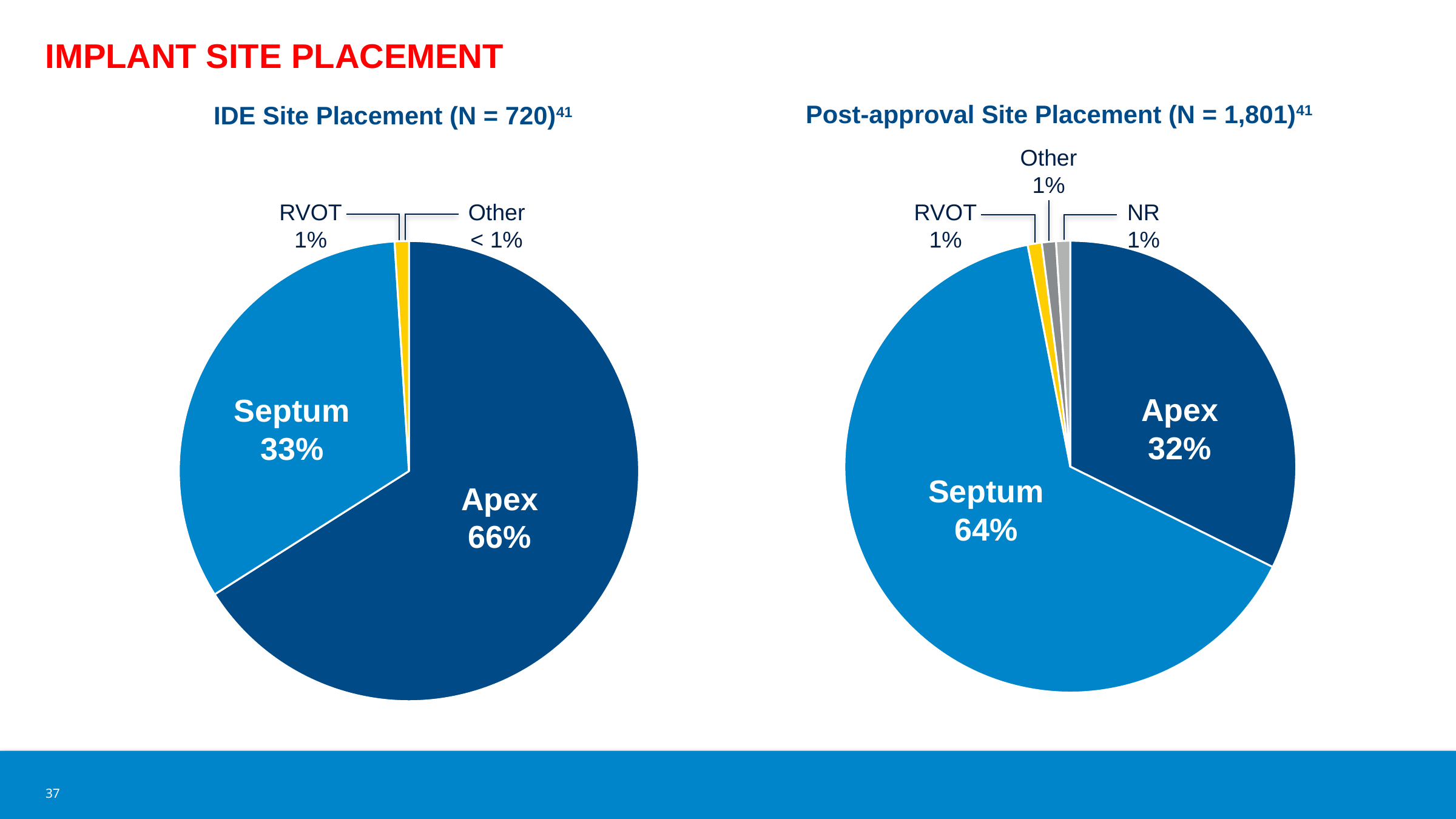
In the IDE Site Placement chart, what share of implants were placed at the Septum? 33% In the Post-approval Site Placement chart, what share of implants were placed at the Apex? 32% In the Post-approval Site Placement chart, what share is labelled NR? 1% In the Post-approval Site Placement chart, which is larger, the Septum share or the Apex share? Septum In the Post-approval Site Placement chart, what share of implants were placed at the Septum? 64% In the IDE Site Placement chart, what is the difference between the Apex and Septum shares? 33% What type of chart is used for IDE Site Placement? Pie chart In the Post-approval Site Placement chart, what is the difference between the Septum and Apex shares? 32% In the IDE Site Placement chart, what share of implants were placed at the Apex? 66% In the Post-approval Site Placement chart, which site has the largest share? Septum How many slices does the Post-approval Site Placement pie chart have? 5 In the IDE Site Placement chart, which site has the largest share? Apex